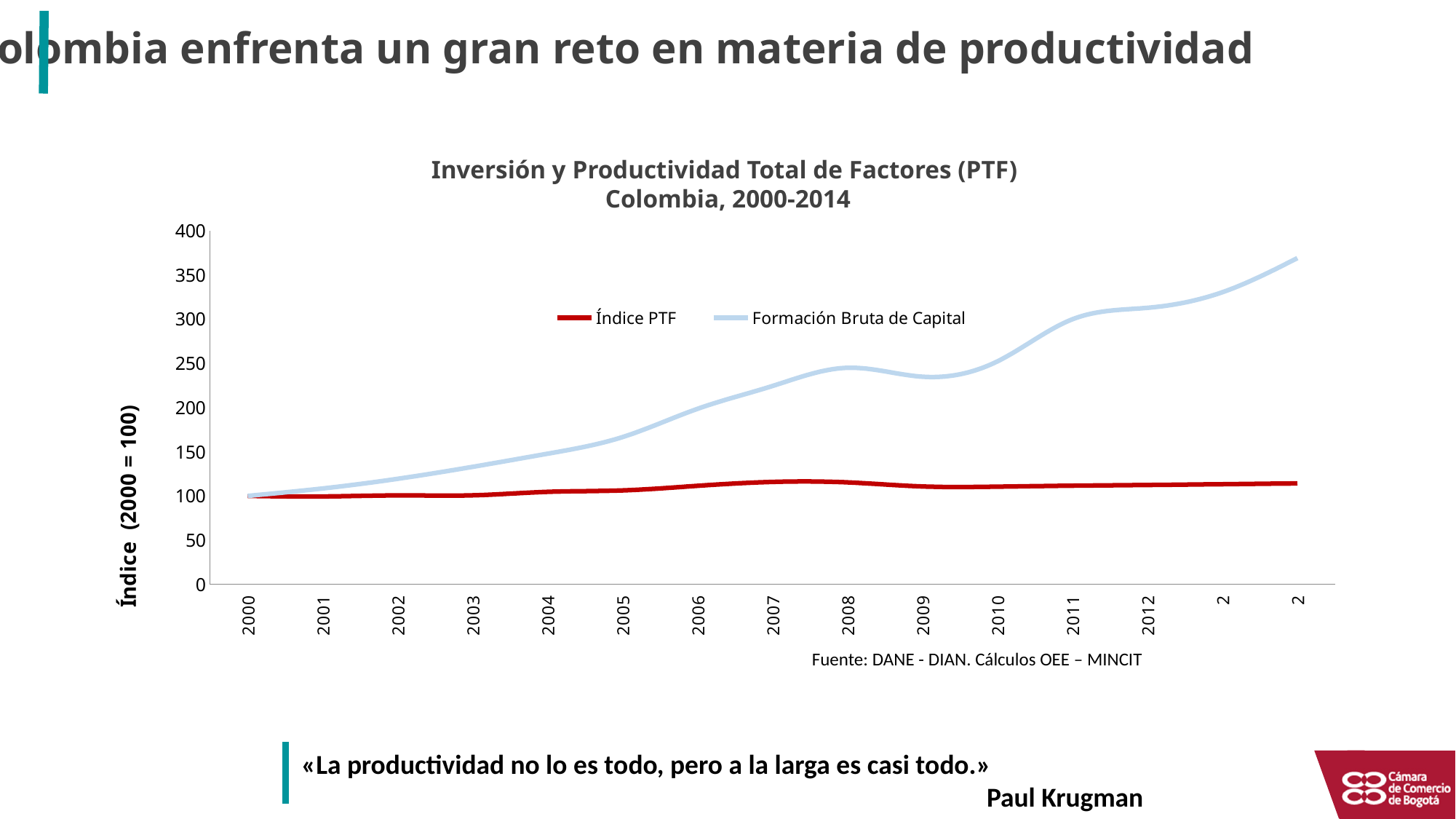
Which series has the higher value in 2012, Índice PTF or Formación Bruta de Capital? Formación Bruta de Capital How many series does the chart legend list? 2 What is the value of the Índice PTF series in 2000? 100 Is the value of Índice PTF in 2007 greater or less than 150? less Is the value of Formación Bruta de Capital in 2014 greater or less than 350? greater What kind of chart is shown on the slide? line chart What is the value of the Formación Bruta de Capital series in 2000? 100 What are the two series named in the chart legend? Índice PTF and Formación Bruta de Capital What is the title of the chart's vertical axis? Índice (2000 = 100) Is the value of Formación Bruta de Capital in 2008 greater or less than 200? greater Which series reaches the highest value on the chart? Formación Bruta de Capital Does the Formación Bruta de Capital series generally rise or fall from 2000 to 2014? rise